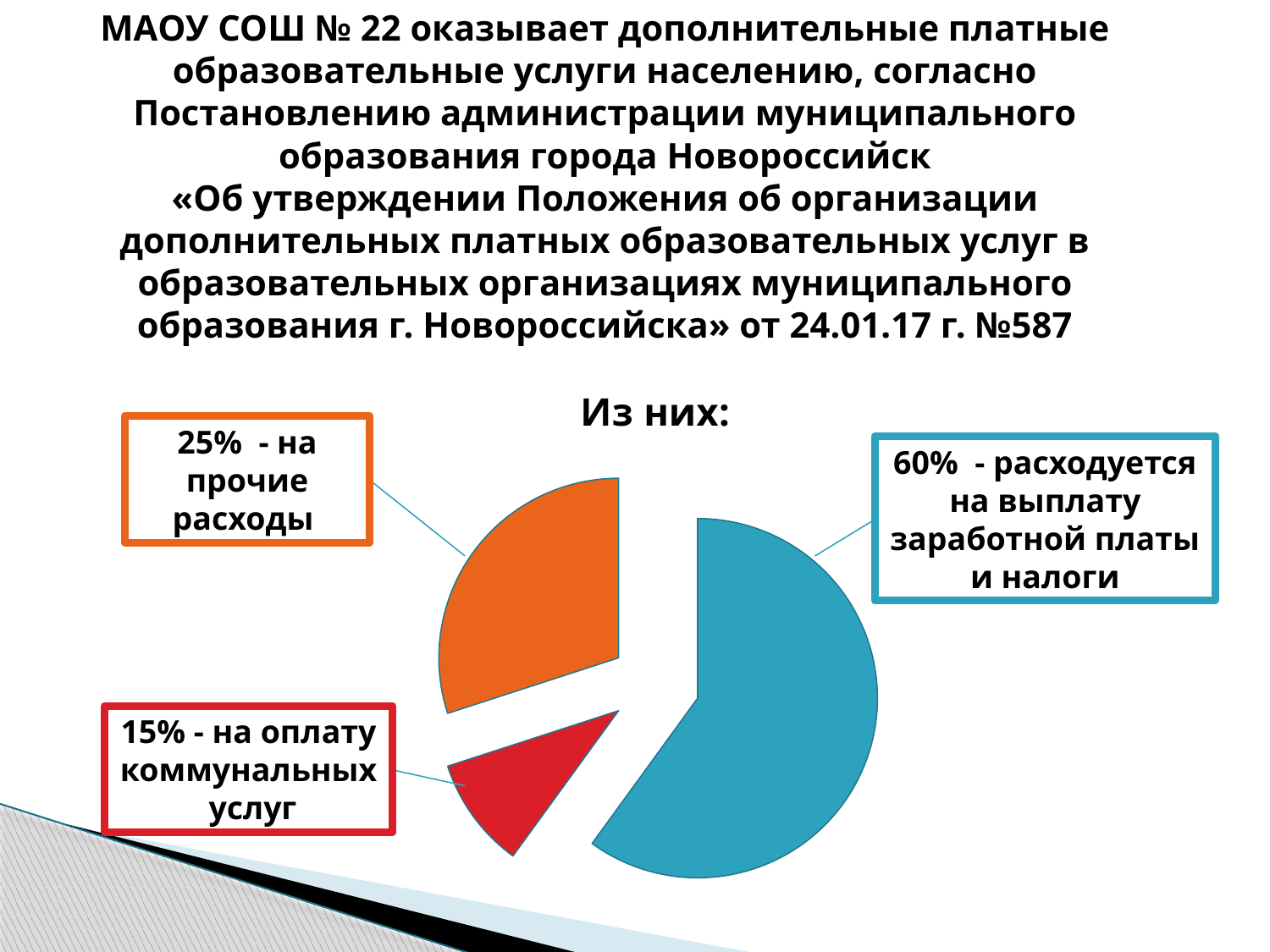
What share of the pie goes to other expenses (прочие расходы)? 25% Which category has the smallest slice of the pie? оплата коммунальных услуг What colour is the slice representing salary payments and taxes? blue Which category has the largest slice of the pie? выплата заработной платы и налоги How many slices does the pie chart have? 3 What share of the pie is spent on salary payments and taxes (выплату заработной платы и налоги)? 60% What share of the pie goes to utility payments (оплату коммунальных услуг)? 15% What kind of chart is shown on the slide? pie chart What is the difference between the share for other expenses and the share for utility payments? 10% Which is larger: the share for other expenses or the share for utility payments? прочие расходы What is the title of the pie chart? Из них: What is the difference between the share for salary and taxes and the share for other expenses? 35%